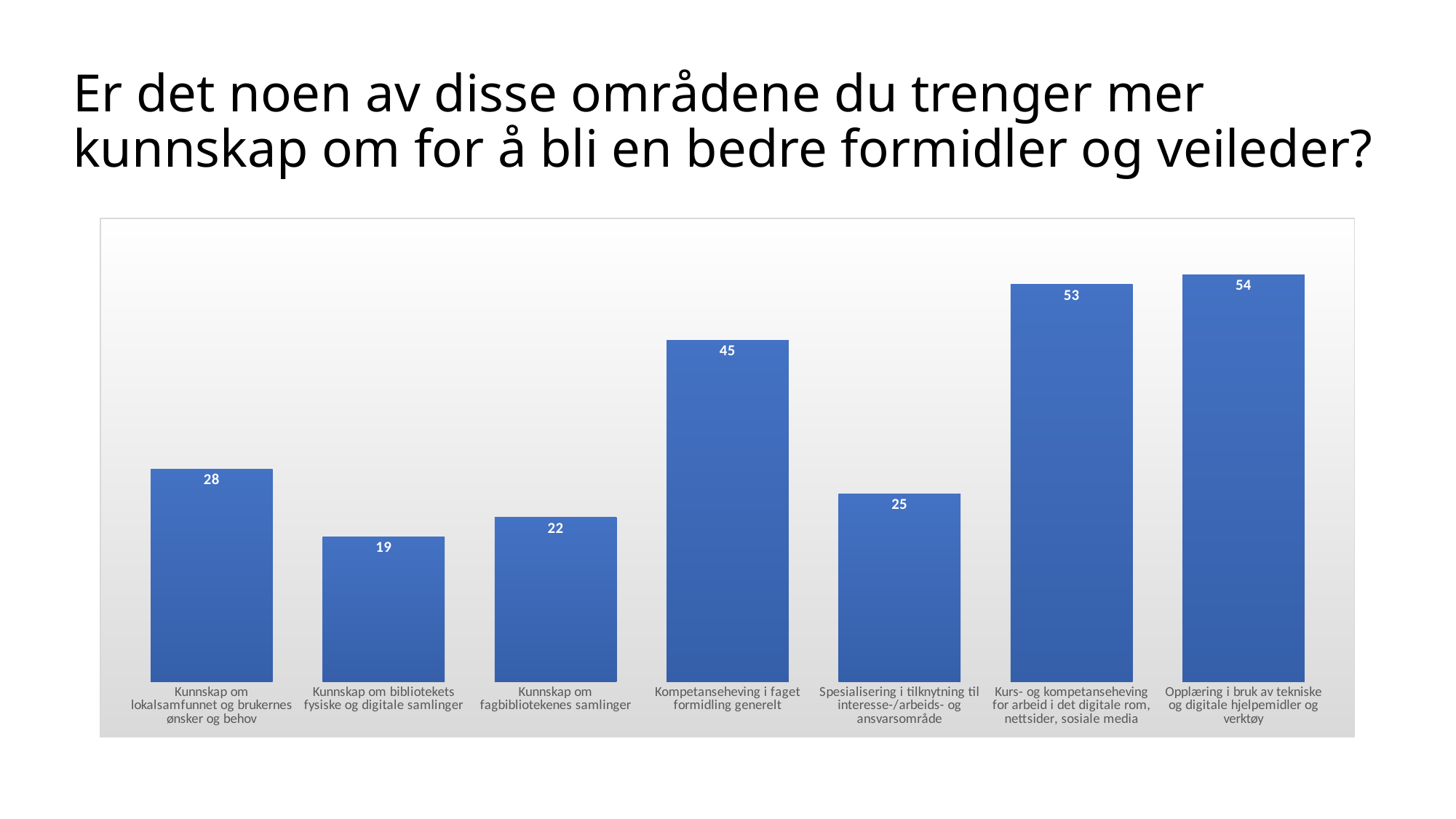
Which category has the lowest value? Kunnskap om bibliotekets fysiske og digitale samlinger What kind of chart is shown on the slide? Bar chart What is the value for "Spesialisering i tilknytning til interesse-/arbeids- og ansvarsområde"? 25 What is the title of the slide containing the chart? Er det noen av disse områdene du trenger mer kunnskap om for å bli en bedre formidler og veileder? What is the difference between the values for "Opplæring i bruk av tekniske og digitale hjelpemidler og verktøy" and "Kurs- og kompetanseheving for arbeid i det digitale rom, nettsider, sosiale media"? 1 What is the difference between the values for "Kurs- og kompetanseheving for arbeid i det digitale rom, nettsider, sosiale media" and "Kunnskap om fagbibliotekenes samlinger"? 31 Which is larger: the value for "Kunnskap om lokalsamfunnet og brukernes ønsker og behov" or the value for "Spesialisering i tilknytning til interesse-/arbeids- og ansvarsområde"? Kunnskap om lokalsamfunnet og brukernes ønsker og behov What is the value for "Kunnskap om lokalsamfunnet og brukernes ønsker og behov"? 28 What is the value for "Kunnskap om bibliotekets fysiske og digitale samlinger"? 19 How many categories are shown in the chart? 7 What is the value for "Kompetanseheving i faget formidling generelt"? 45 Which category has the highest value? Opplæring i bruk av tekniske og digitale hjelpemidler og verktøy